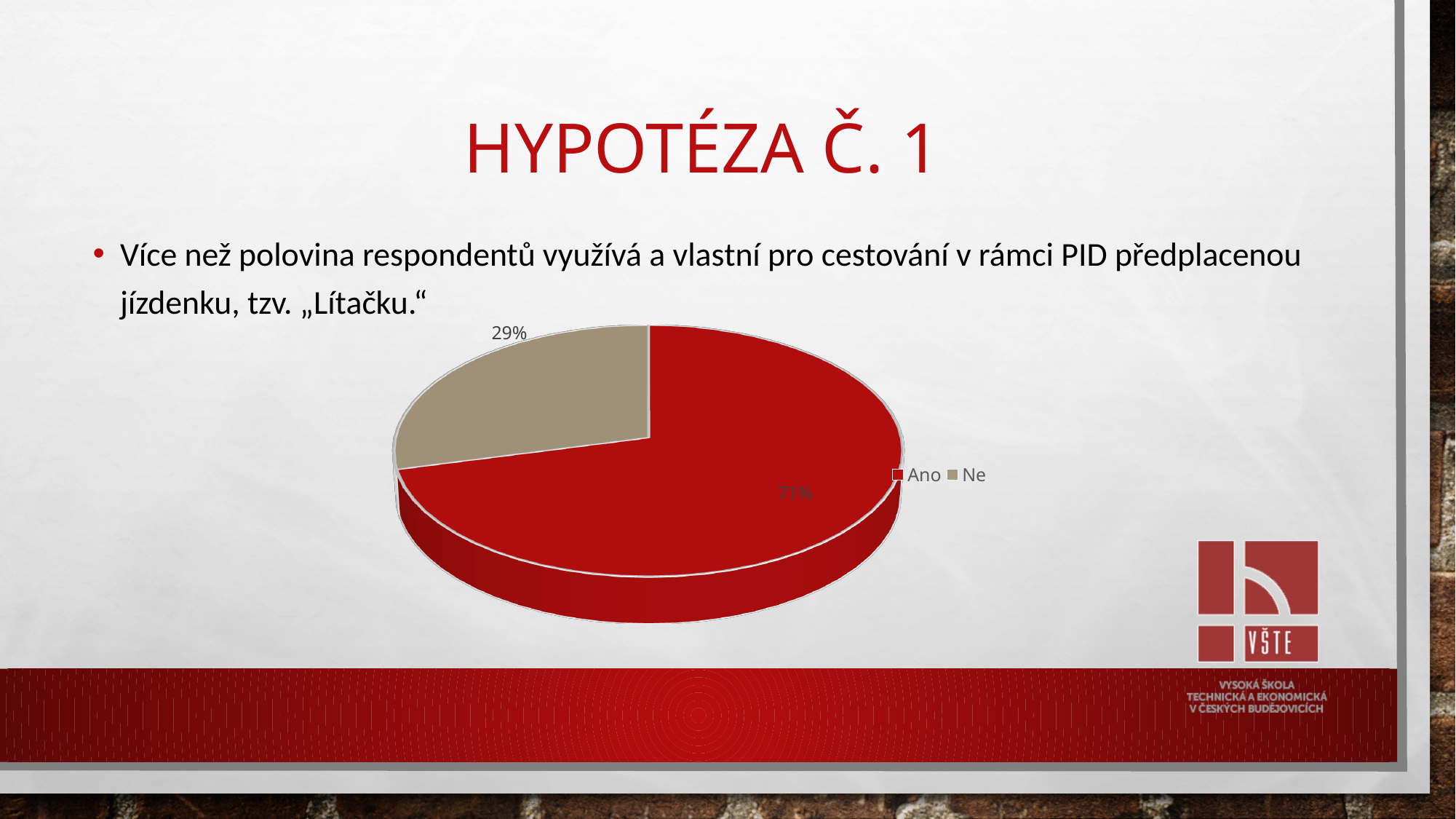
Which is larger, the "Ano" slice or the "Ne" slice? Ano How many slices does the pie chart have? 2 How many entries does the legend list? 2 What share of the pie does the "Ano" slice represent? 71% What kind of chart is shown on the slide? pie chart What colour is the "Ne" slice? beige What is the difference in percentage points between the "Ano" and "Ne" slices? 42 What colour is the "Ano" slice? red Which slice of the pie is the largest? Ano What share of the pie does the "Ne" slice represent? 29% Which slice of the pie is the smallest? Ne